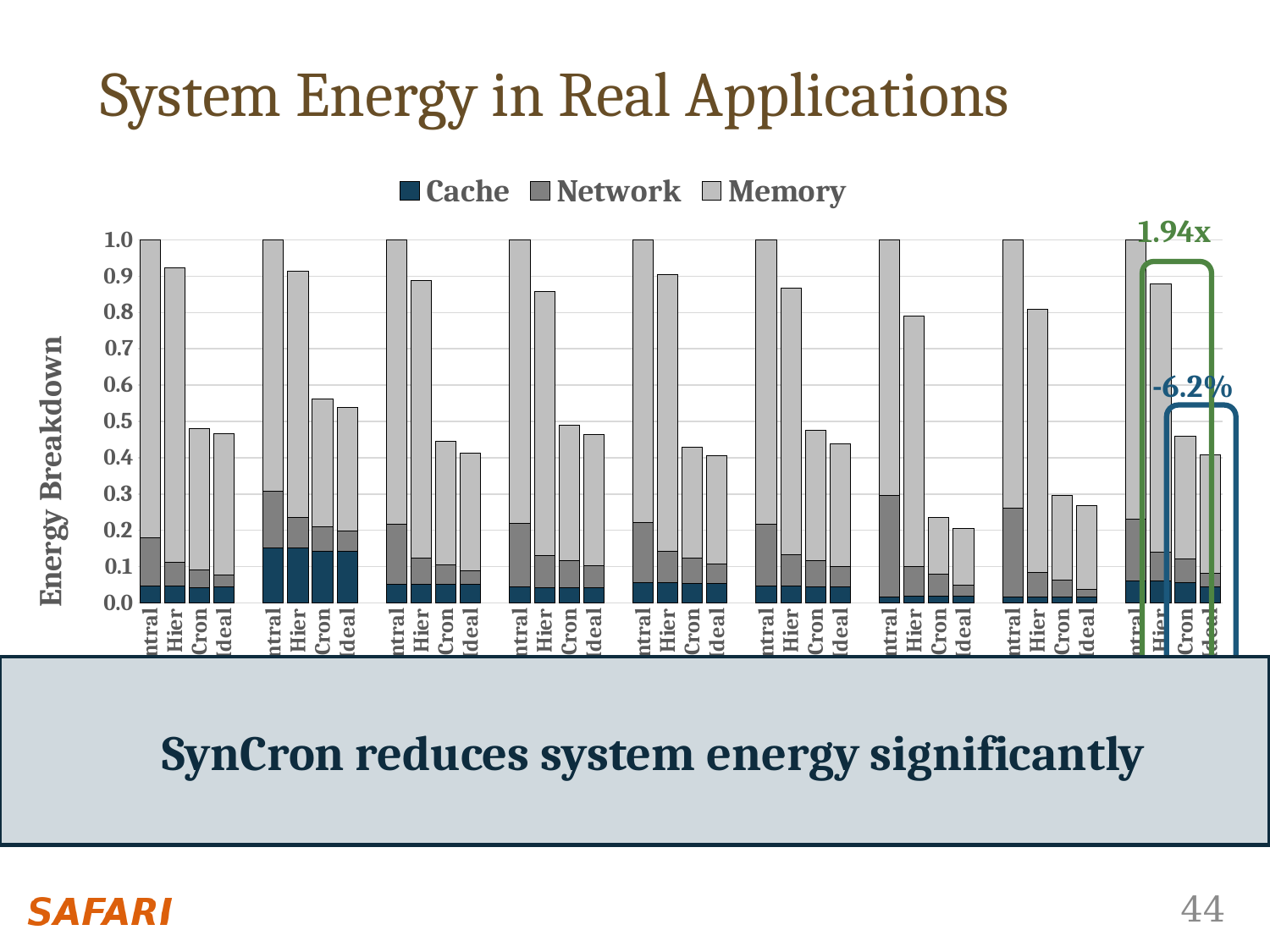
In the second group from the left, is the total for Cron greater or less than 0.5? greater In the seventh group from the left, is the total for Ideal greater or less than 0.3? less What is the label on the y axis? Energy Breakdown What are the three series named in the legend? Cache, Network, Memory How many bars are there in each group? 4 How many groups of bars are plotted along the x axis? 9 Within each group, do the bar totals rise or fall from left to right? fall In the rightmost group, which has the larger total, Hier or Cron? Hier What kind of chart is shown on the slide? stacked bar chart In the rightmost group, is the total for Hier greater or less than 0.9? less How many series does the legend list? 3